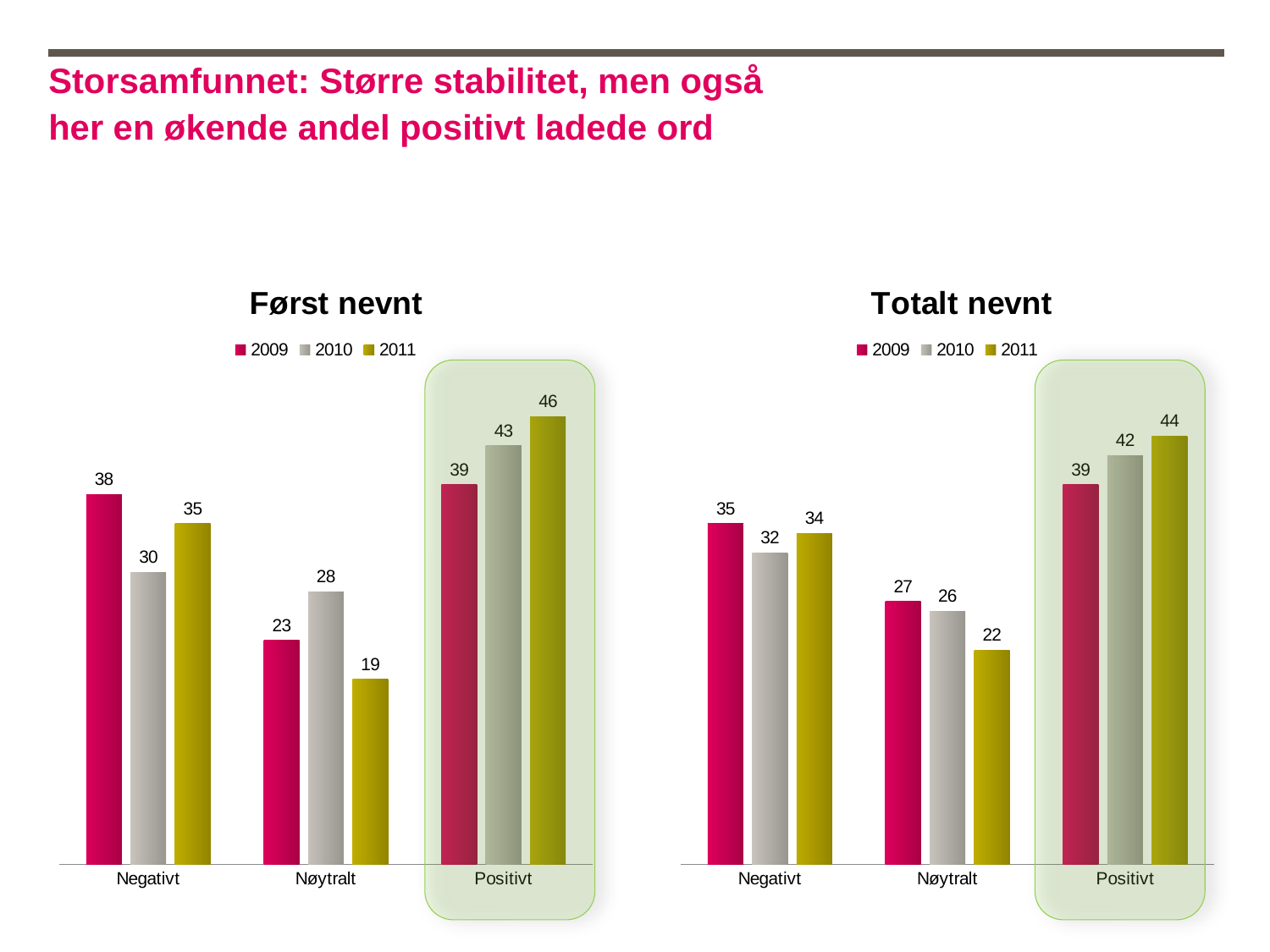
In the 'Først nevnt' chart, which is larger for Nøytralt: the 2010 value or the 2009 value? 2010 What kind of chart is the 'Totalt nevnt' chart? Bar chart In the 'Først nevnt' chart, what is the difference between the 2009 and 2011 values for Negativt? 3 How many series does the legend of the 'Totalt nevnt' chart list? 3 In the 'Først nevnt' chart, which category has the lowest value for 2011? Nøytralt In the 'Totalt nevnt' chart, what is the value for 2010 in the Negativt category? 32 How many categories are shown on the x axis of the 'Først nevnt' chart? 3 In the 'Totalt nevnt' chart, which category has the highest value for 2009? Positivt In the 'Totalt nevnt' chart, what is the difference between the 2011 and 2009 values for Positivt? 5 In the 'Først nevnt' chart, what is the value for 2011 in the Positivt category? 46 In the 'Totalt nevnt' chart, do the values for Nøytralt rise or fall from 2009 to 2011? Fall In the 'Totalt nevnt' chart, which is larger for Negativt: the 2009 value or the 2011 value? 2009